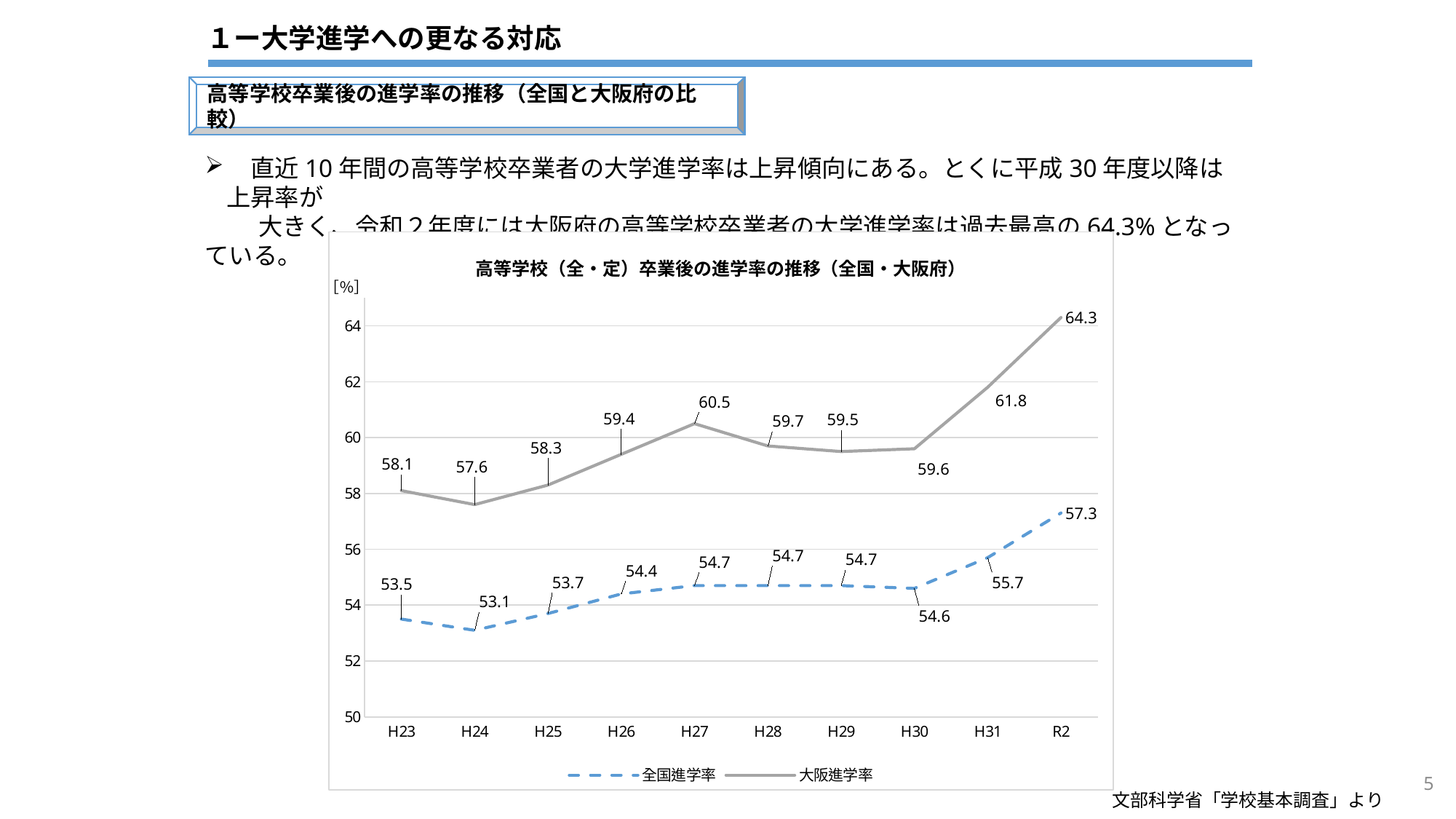
What is the value of 大阪進学率 in R2? 64.3 What type of chart is shown on the slide? line chart Does 大阪進学率 rise or fall from H30 to R2? rise In which year is 全国進学率 lowest? H24 In which year is 大阪進学率 highest? R2 How many series does the legend list? 2 What is the value of 全国進学率 in H24? 53.1 Which is larger in H30: 大阪進学率 or 全国進学率? 大阪進学率 What is the difference between 大阪進学率 and 全国進学率 in R2? 7.0 Which series is drawn with a dashed line? 全国進学率 What is the value of 大阪進学率 in H27? 60.5 How many years are plotted along the x axis? 10